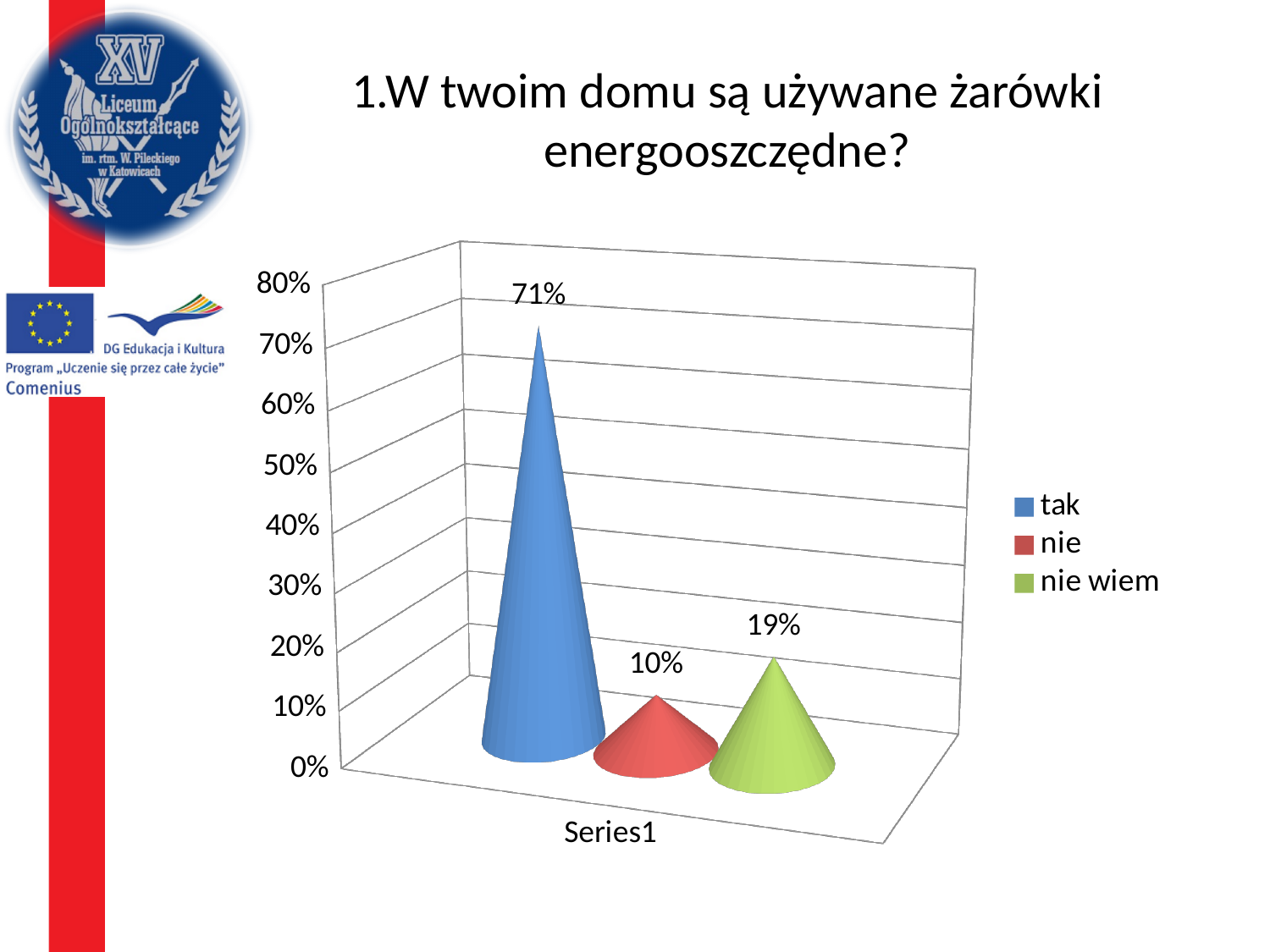
What is the difference between the values for "tak" and "nie wiem"? 52% What is the value for "nie"? 10% Which answer has the highest value? tak What is the value for "tak"? 71% What is the value for "nie wiem"? 19% Which answer has the lowest value? nie What kind of chart is shown on the slide? bar chart What colour is the bar for "nie wiem"? green Is the value for "tak" greater or less than 60%? greater Which is larger, the value for "nie" or the value for "nie wiem"? nie wiem How many entries does the legend list? 3 What is the difference between the values for "nie wiem" and "nie"? 9%